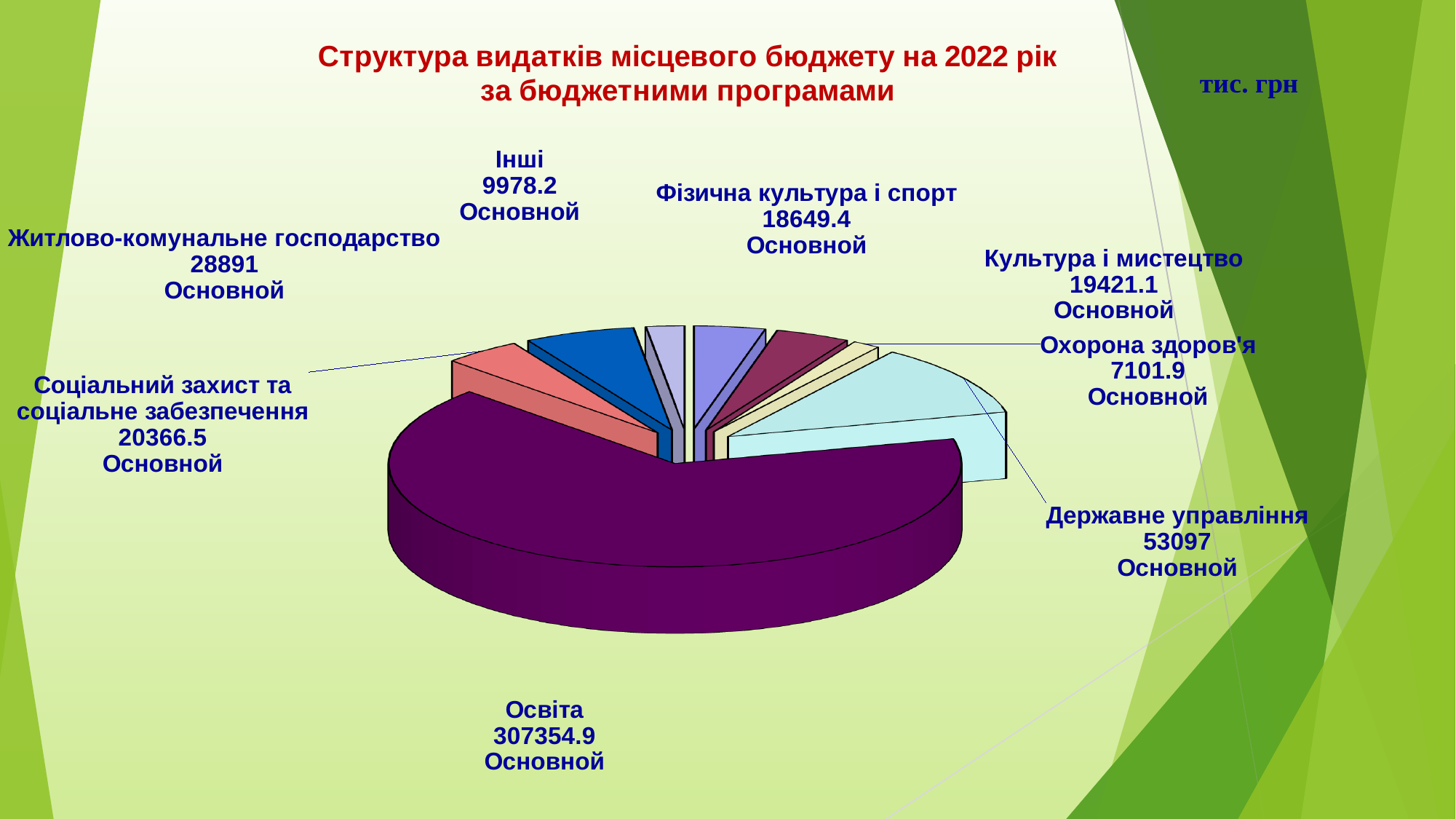
What unit is indicated for the values on the slide? тис. грн What is the value for Державне управління? 53097 What is the value for Охорона здоров'я? 7101.9 What is the value for Житлово-комунальне господарство? 28891 What kind of chart is shown on the slide? pie chart What is the difference between the values for Державне управління and Житлово-комунальне господарство? 24206 What is the value for Освіта? 307354.9 How many slices does the pie chart have? 8 Which category has the smallest value? Охорона здоров'я What is the title of the chart? Структура видатків місцевого бюджету на 2022 рік за бюджетними програмами Which category has the largest value? Освіта Which is larger, the value for Соціальний захист та соціальне забезпечення or the value for Культура і мистецтво? Культура і мистецтво